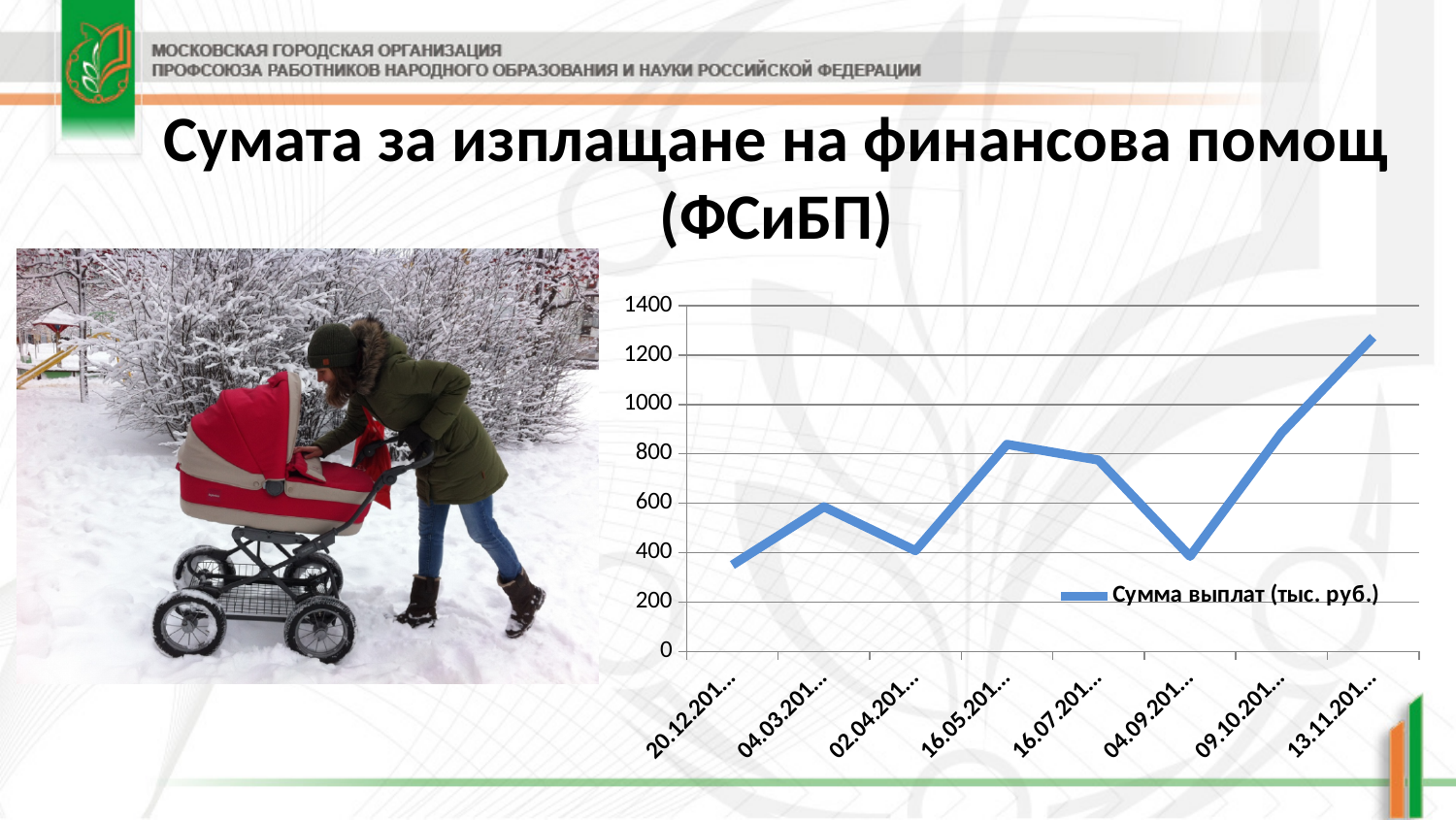
Which date has the highest value on the chart? 13.11.201... Which is larger, the value for 09.10.201... or the value for 04.09.201...? 09.10.201... What kind of chart is shown on the slide? line chart Do the values rise or fall from 04.09.201... to 13.11.201...? rise Is the value for 04.09.201... greater or less than 600? less How many series does the legend of the chart list? 1 How many data points are plotted on the line chart? 8 Is the value for 02.04.201... greater or less than 600? less Is the value for 13.11.201... greater or less than 1200? greater Which is larger, the value for 16.05.201... or the value for 02.04.201...? 16.05.201... What is the legend entry of the series plotted on the chart? Сумма выплат (тыс. руб.)